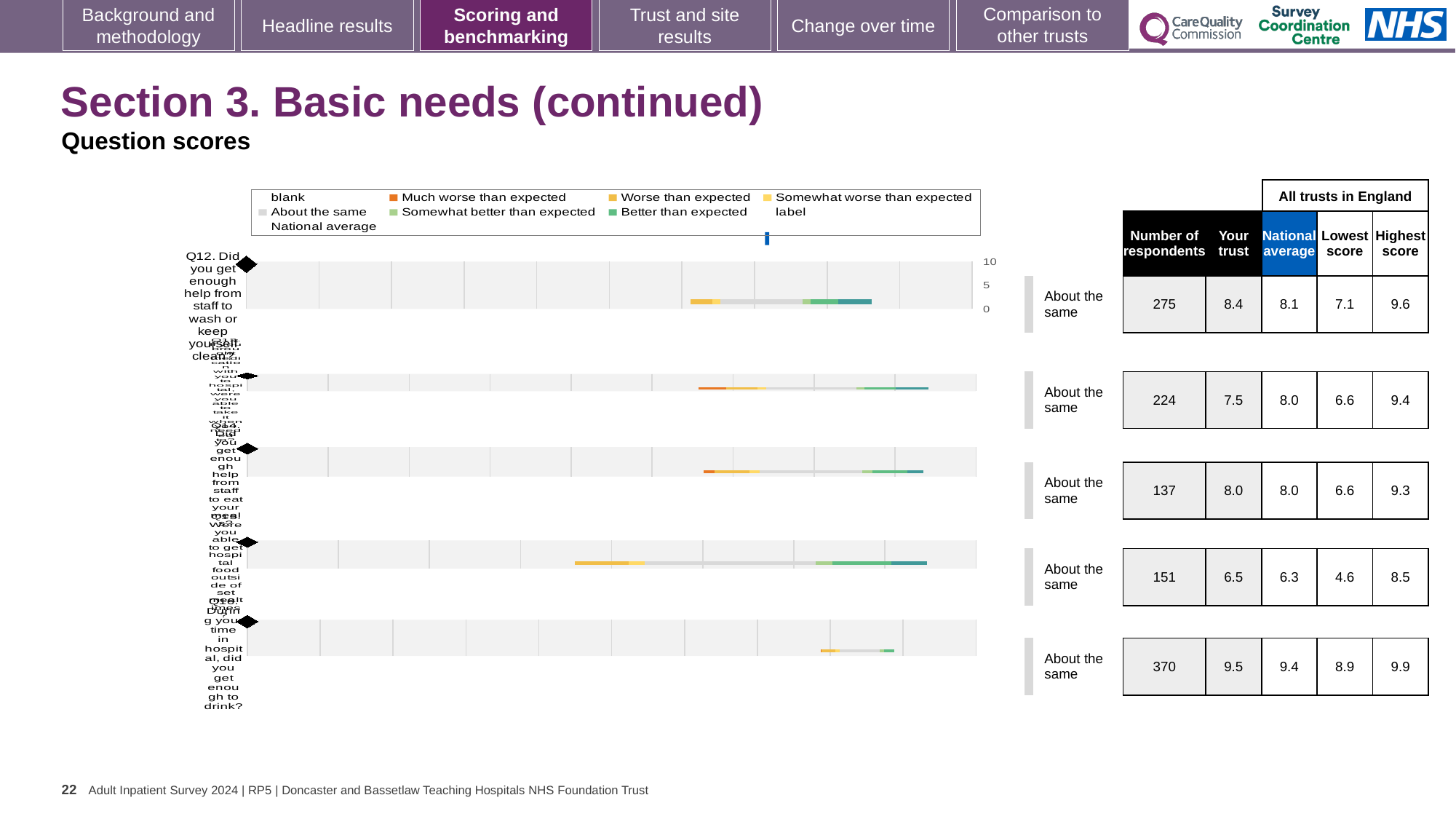
What kind of chart is shown on the slide? bar chart What benchmark category is shown for Q12? About the same What is the 'Your trust' score for Q12 (help from staff to wash or keep yourself clean)? 8.4 How many respondents are listed for Q12 (help from staff to wash or keep yourself clean)? 275 Which row has the highest 'Your trust' score? the bottom row (9.5) For Q12, which is larger: the 'Your trust' score or the national average? Your trust What is the title of the slide? Section 3. Basic needs (continued) What colour does the legend use for 'Much worse than expected'? orange Which row has the lowest 'Lowest score' value? the fourth row (4.6) How many question rows (bars) does the chart show? 5 What is the national average for Q12 (help from staff to wash or keep yourself clean)? 8.1 For Q12, what is the difference between the highest score and the lowest score across all trusts in England? 2.5